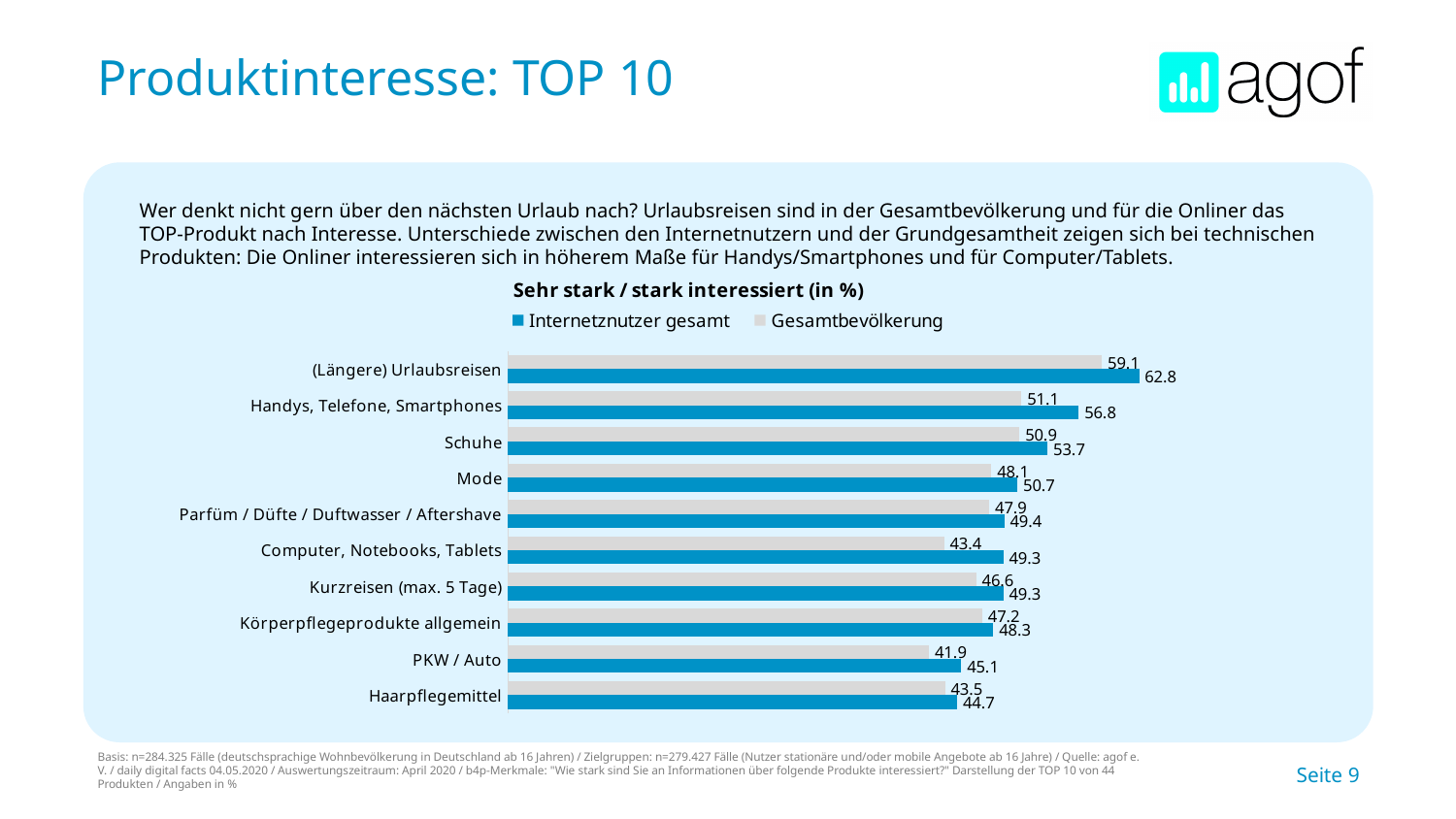
Which colour represents the Gesamtbevölkerung series? grey Which category has the lowest value for Gesamtbevölkerung? PKW / Auto How many series does the legend list? 2 Which category has the highest value for Internetznutzer gesamt? (Längere) Urlaubsreisen What is the value for Internetznutzer gesamt for (Längere) Urlaubsreisen? 62.8 What is the value for Gesamtbevölkerung for Computer, Notebooks, Tablets? 43.4 What is the difference between Internetznutzer gesamt and Gesamtbevölkerung for Handys, Telefone, Smartphones? 5.7 Which is larger for Computer, Notebooks, Tablets: the value for Internetznutzer gesamt or for Gesamtbevölkerung? Internetznutzer gesamt What type of chart is shown on the slide? bar chart What is the title of the chart? Sehr stark / stark interessiert (in %) How many product categories are shown in the chart? 10 What is the value for Internetznutzer gesamt for PKW / Auto? 45.1